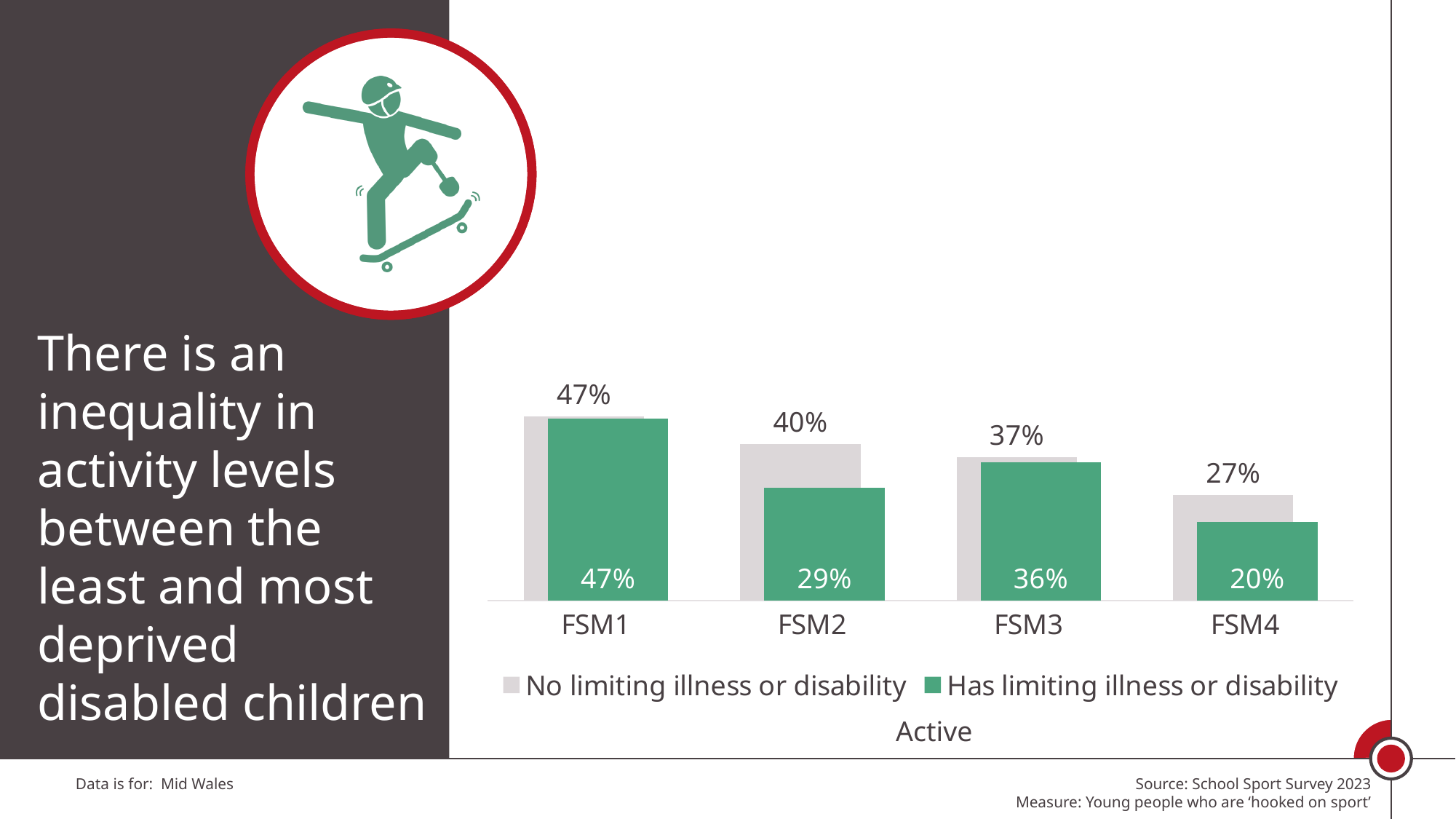
Which category has the lowest value in the 'Has limiting illness or disability' series? FSM4 What is the difference between the 'No limiting illness or disability' and 'Has limiting illness or disability' values for FSM2? 11% What is the value for FSM2 in the 'No limiting illness or disability' series? 40% What is the value for FSM4 in the 'Has limiting illness or disability' series? 20% How many categories are shown on the x axis? 4 Which is larger for FSM3: the 'No limiting illness or disability' value or the 'Has limiting illness or disability' value? No limiting illness or disability What is the x-axis title of the chart? Active What is the difference between the 'No limiting illness or disability' and 'Has limiting illness or disability' values for FSM4? 7% How many series does the legend list? 2 Which category has the highest value in the 'No limiting illness or disability' series? FSM1 What kind of chart is shown on the slide? Bar chart What is the value for FSM3 in the 'Has limiting illness or disability' series? 36%